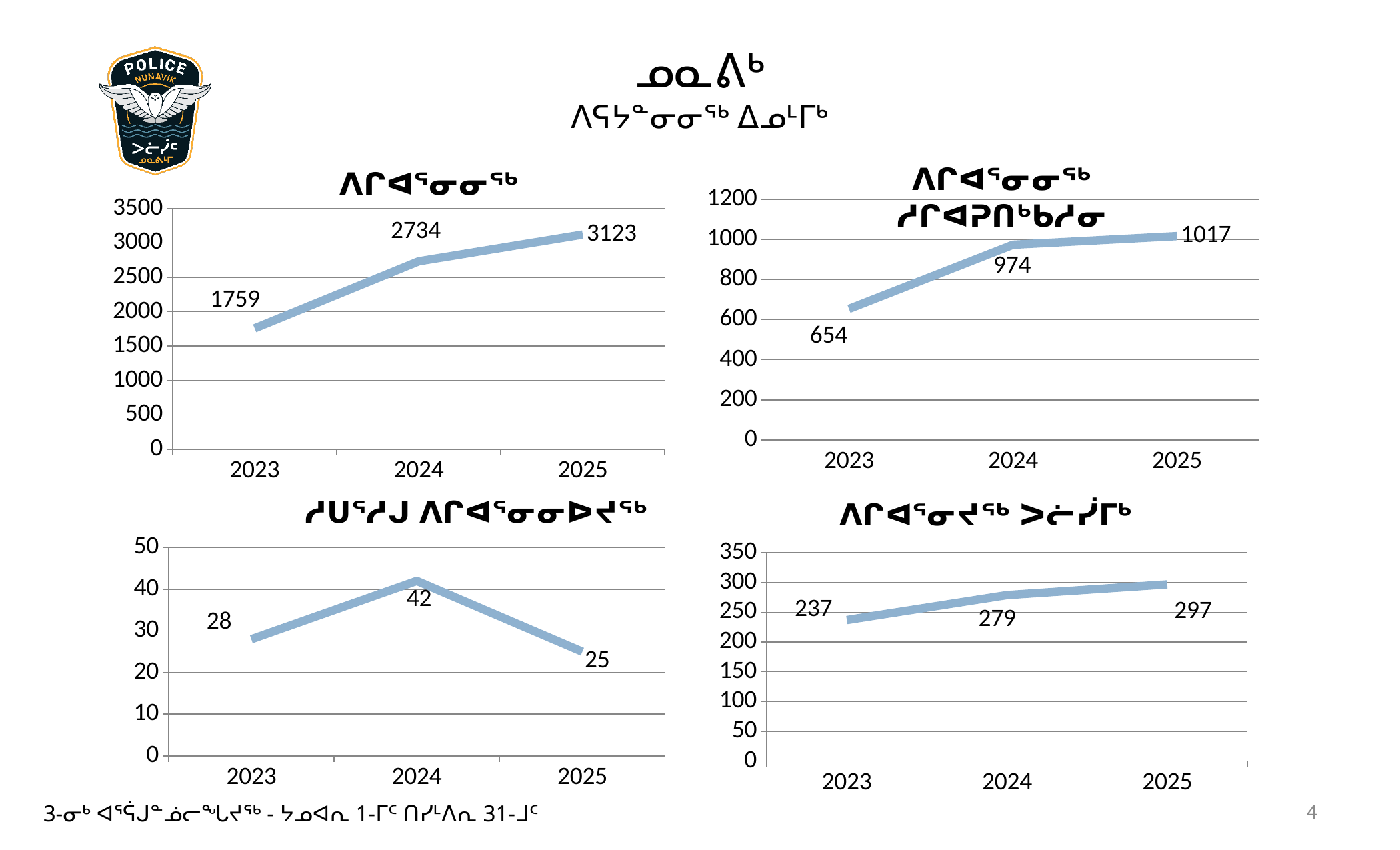
In the bottom-left chart, what is the value for 2024? 42 In the top-left chart, what is the value for 2024? 2734 In the top-right chart, do the values rise or fall from 2023 to 2025? rise In the bottom-left chart, which year has the lowest value? 2025 In the bottom-left chart, which is larger, the value for 2023 or the value for 2025? 2023 In the top-left chart, what is the difference between the 2025 and 2023 values? 1364 In the bottom-right chart, what is the difference between the 2024 and 2023 values? 42 In the top-right chart, what is the value for 2023? 654 How many data points are plotted in the bottom-right chart? 3 In the bottom-right chart, what is the value for 2025? 297 What kind of chart is the top-left chart? line chart In the top-right chart, which year has the highest value? 2025